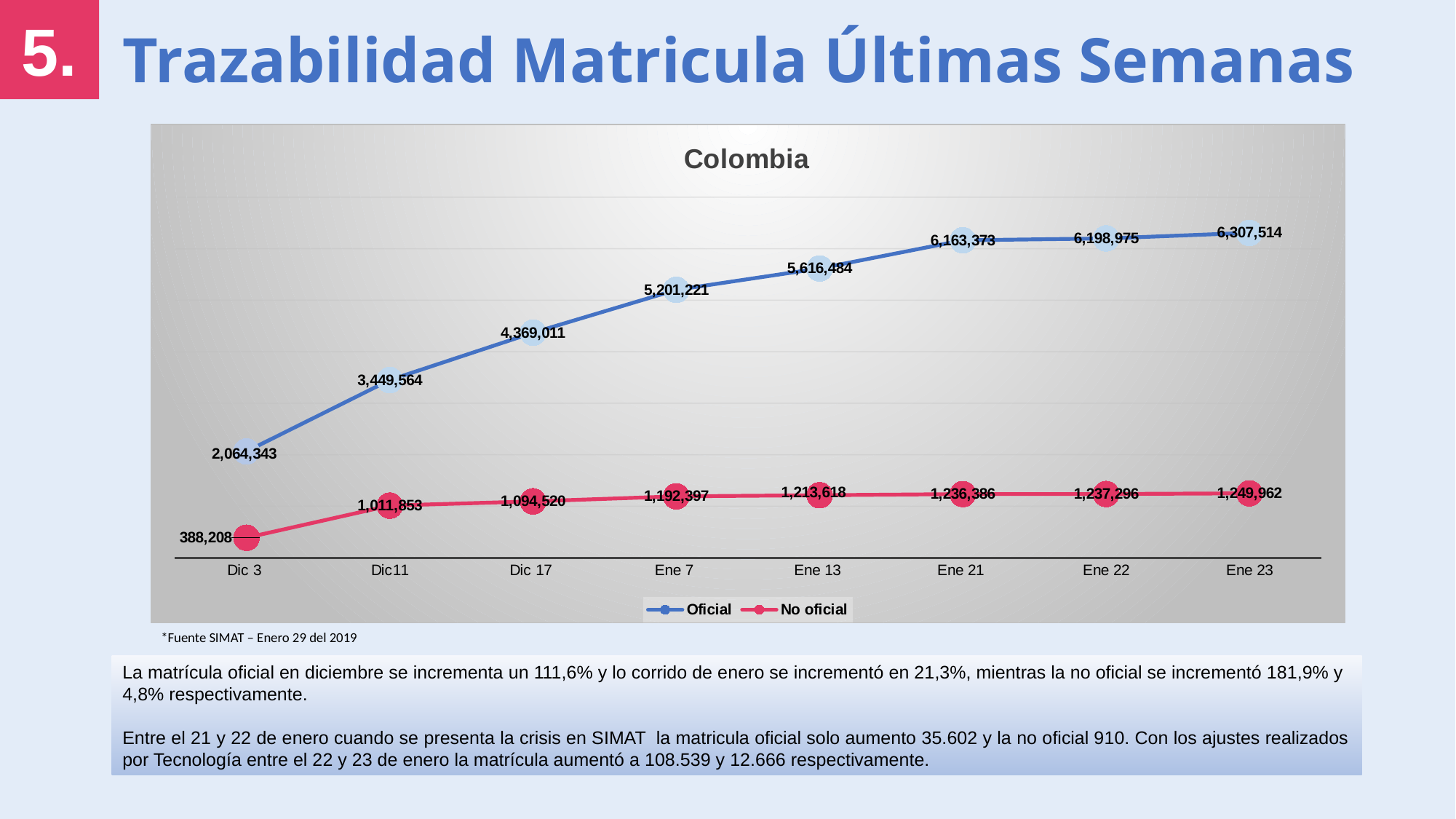
What is the title of the chart? Colombia On which date is the Oficial series lowest? Dic 3 What is the No oficial value on Dic 3? 388,208 By how much did the Oficial value increase from Ene 22 to Ene 23? 108,539 How many dates are plotted along the x axis? 8 Does the Oficial series rise or fall from Dic 3 to Ene 23? Rise On which date is the No oficial series highest? Ene 23 What is the No oficial value on Ene 13? 1,213,618 What is the Oficial value on Ene 23? 6,307,514 What type of chart is shown on the slide? Line chart What is the Oficial value on Dic 17? 4,369,011 How many series does the legend list? 2